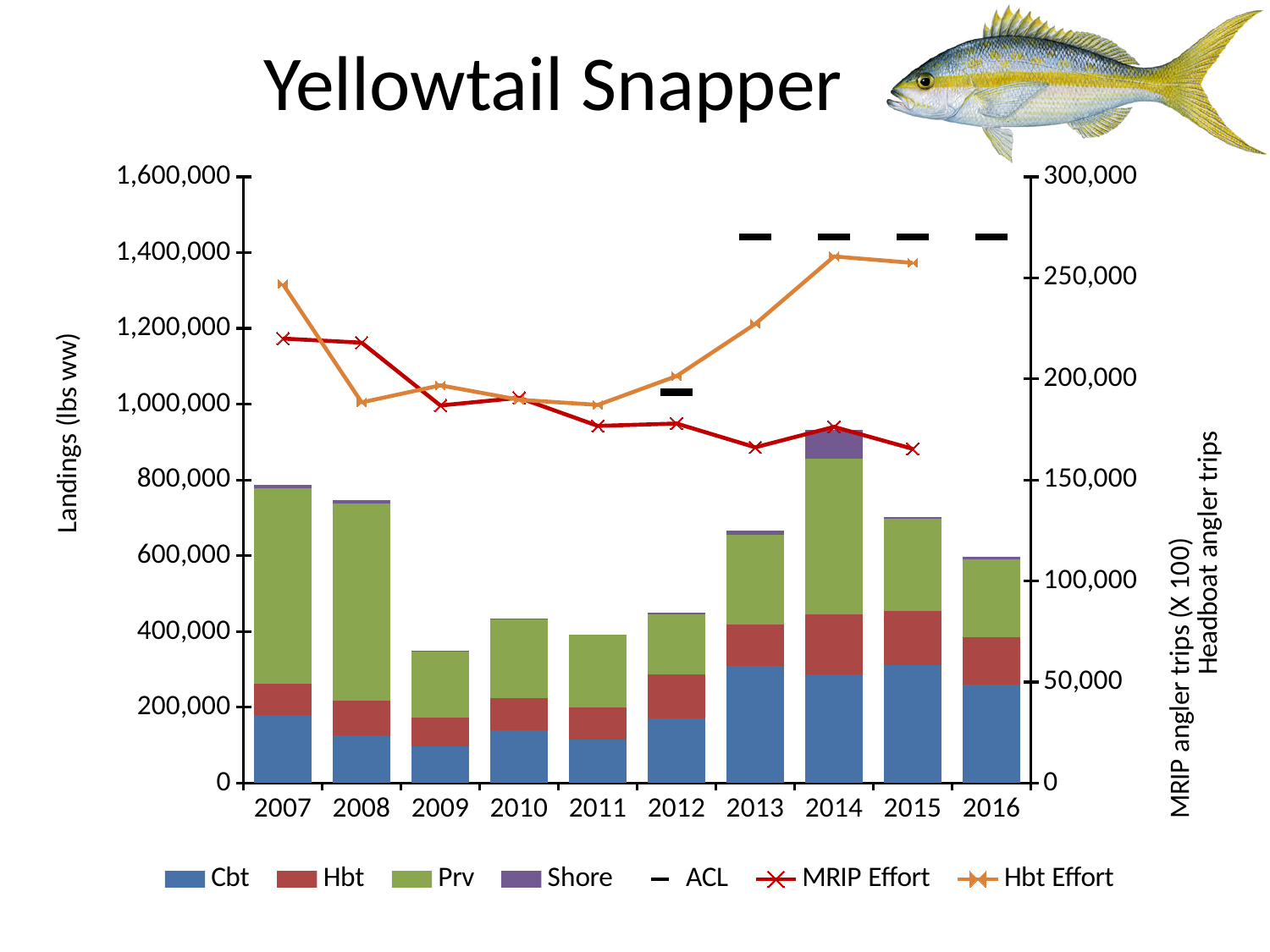
What is the title of the chart on the slide? Yellowtail Snapper How many years are shown along the x axis of the chart? 10 Is the MRIP Effort value for 2007 greater or less than 200,000? greater Does the Hbt Effort line rise or fall from 2011 to 2014? rise Is the total landings value for 2009 greater or less than 400,000? less How many series does the legend list? 7 Is the Hbt Effort value for 2014 greater or less than 250,000? greater Which year has larger total landings, 2007 or 2008? 2007 Which year has the highest total landings (tallest stacked bar)? 2014 Which year has the lowest total landings (shortest stacked bar)? 2009 What kind of chart is shown on the slide? Stacked bar chart combined with line chart